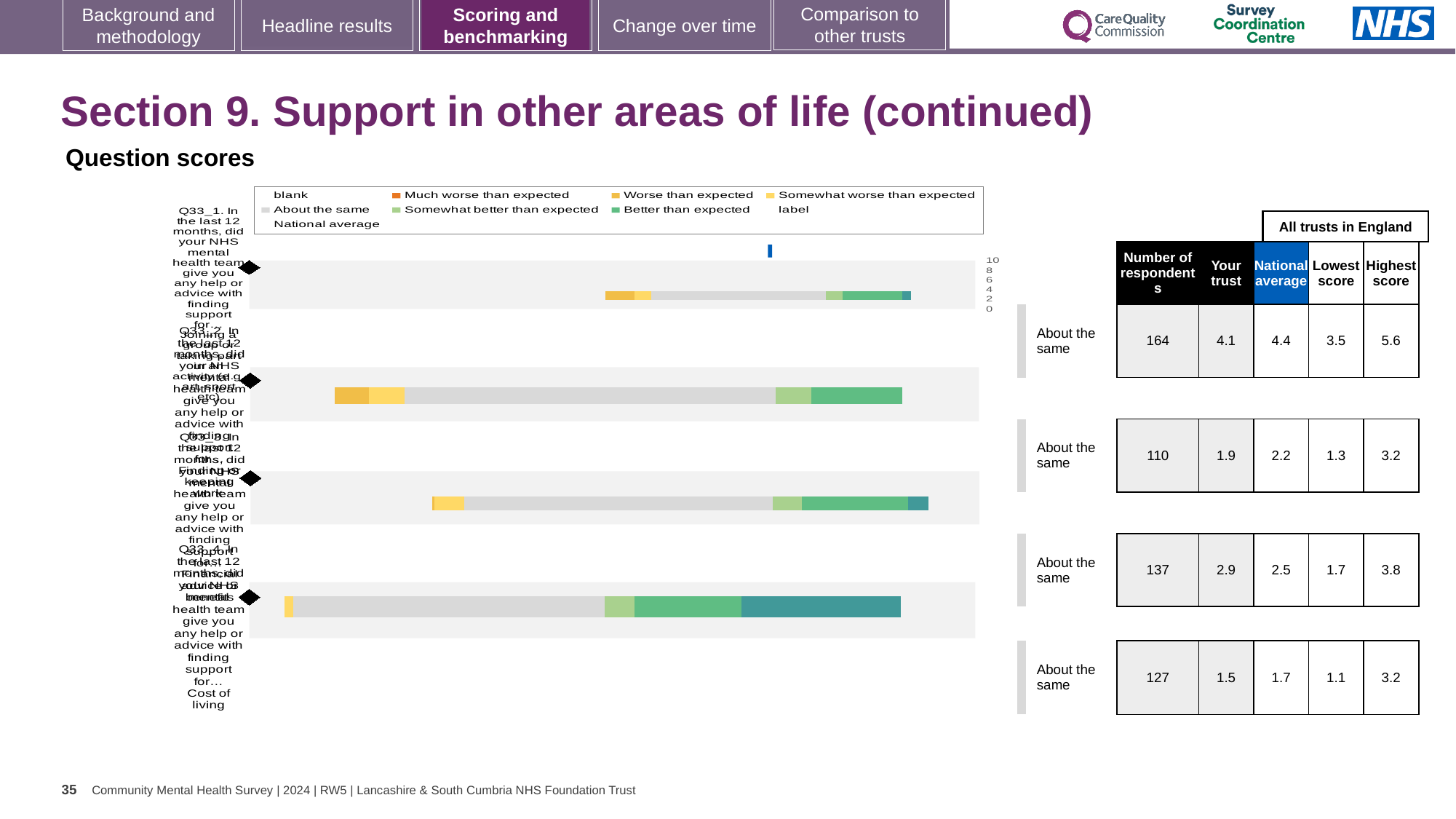
What kind of chart is shown under 'Question scores'? bar chart In the table beside the chart, which question has the highest 'Your trust' score? Q33_1 Which legend entry is shown in light grey? About the same How many entries does the chart legend list? 9 Which legend entry is shown in dark orange? Much worse than expected In the table beside the chart, what is the 'Your trust' score for Q33_1? 4.1 In the table beside the chart, is the 'Your trust' score for Q33_3 larger or smaller than its national average? larger In the table beside the chart, how many respondents answered Q33_3? 137 How many question bars are plotted in the chart? 4 In the table beside the chart, which question has the lowest 'Your trust' score? Q33_4 In the table beside the chart, what is the national average for Q33_2? 2.2 In the table beside the chart, what is the highest score for Q33_4? 3.2